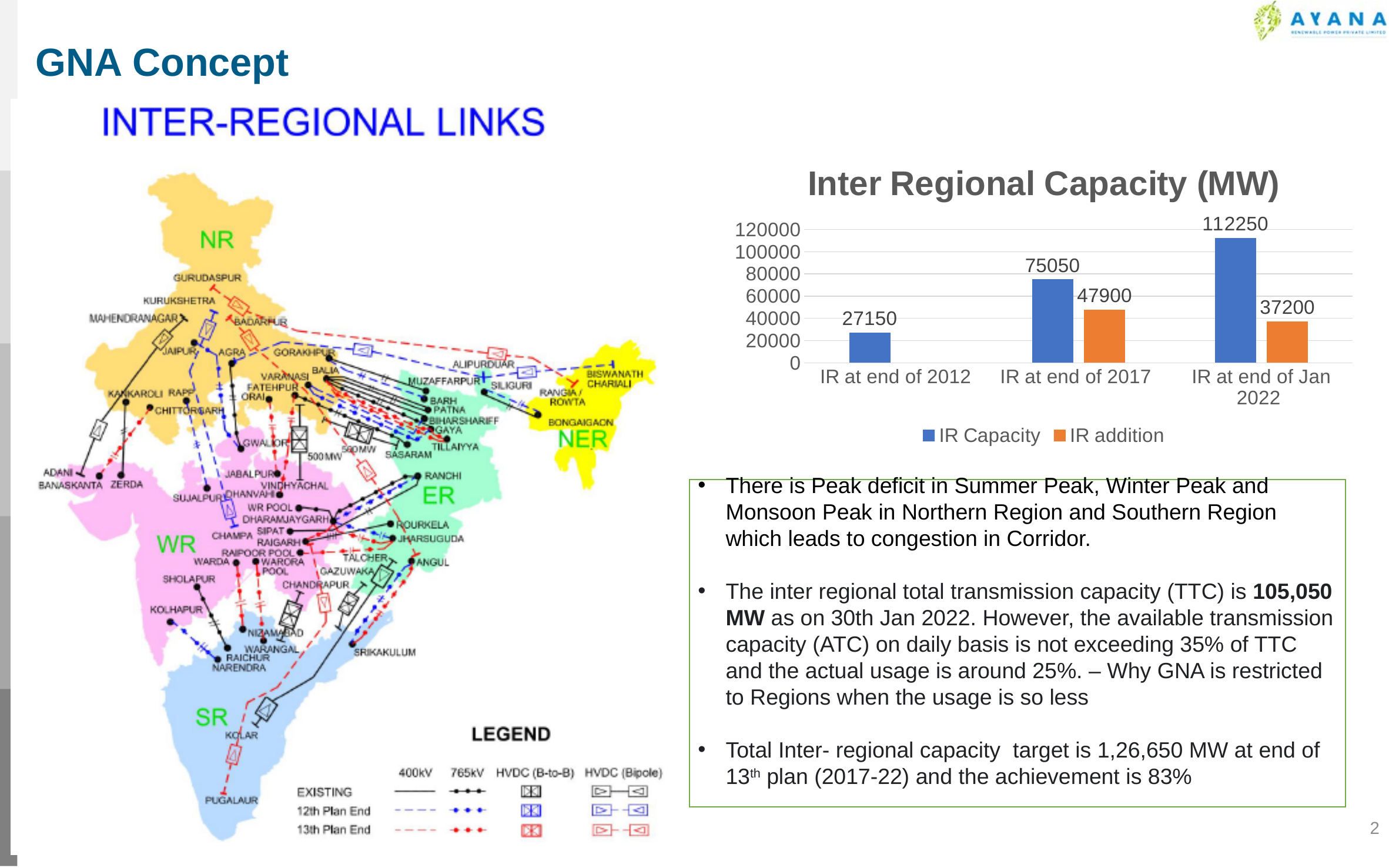
Which category has the highest IR Capacity? IR at end of Jan 2022 Which is larger: the IR addition at end of 2017 or the IR addition at end of Jan 2022? IR addition at end of 2017 What is the IR Capacity at end of Jan 2022? 112250 What is the difference between the IR Capacity at end of Jan 2022 and at end of 2017? 37200 How many series does the chart legend list? 2 What type of chart is used to show Inter Regional Capacity (MW)? Bar chart What is the IR Capacity at end of 2012? 27150 What is the IR Capacity at end of 2017? 75050 Which category has the lowest IR Capacity? IR at end of 2012 What is the IR addition value for IR at end of 2017? 47900 Does the IR Capacity rise or fall from IR at end of 2012 to IR at end of Jan 2022? Rise How many categories are shown on the x axis of the chart? 3